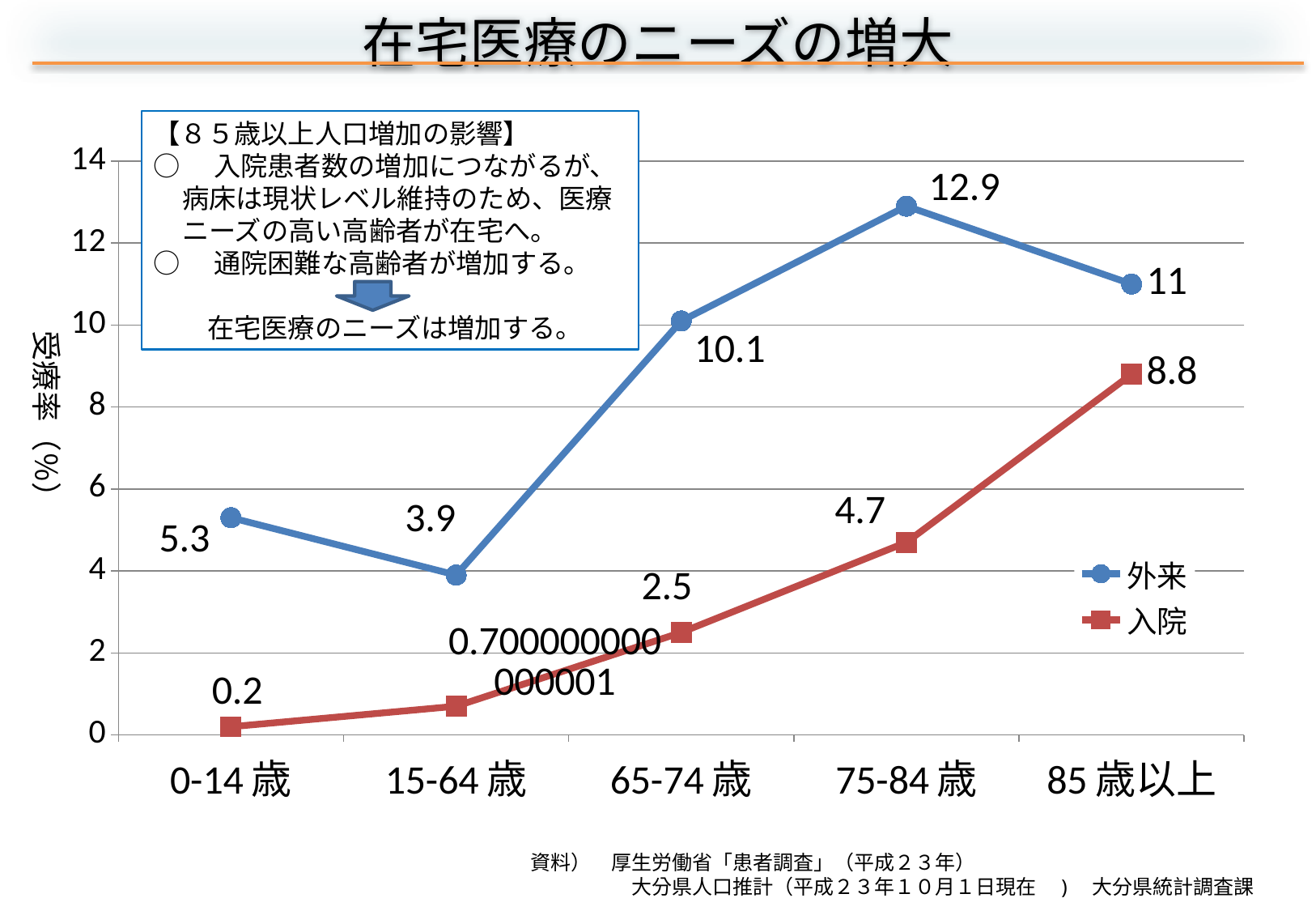
What is the value for 外来 in the 0-14歳 category? 5.3 What is the value for 外来 in the 75-84歳 category? 12.9 Which is larger in the 65-74歳 category, 外来 or 入院? 外来 What is the difference between the 外来 and 入院 values in the 85歳以上 category? 2.2 What is the label of the y axis? 受療率（%） How many series does the legend list? 2 Which age category has the lowest 入院 value? 0-14歳 How many age categories are shown on the x axis? 5 Does the 入院 series rise or fall across the age categories from left to right? rise What is the value for 入院 in the 85歳以上 category? 8.8 Which age category has the highest 外来 value? 75-84歳 What type of chart is shown on the slide? line chart